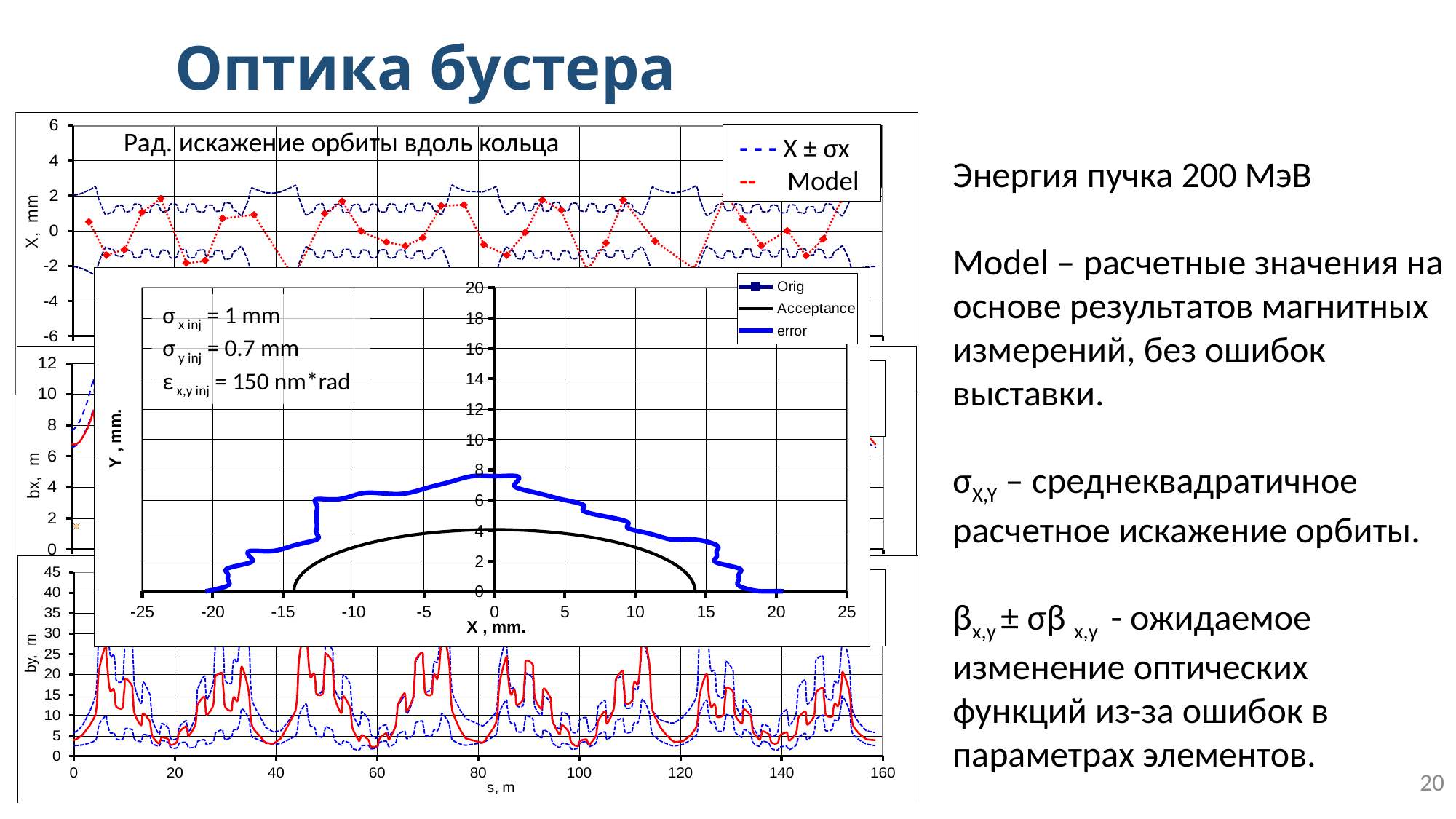
In the top chart titled 'Рад. искажение орбиты вдоль кольца', what are the two legend entries? X ± σx and Model What kind of chart is the top chart titled 'Рад. искажение орбиты вдоль кольца'? line chart In the top chart titled 'Рад. искажение орбиты вдоль кольца', is the value of the Model series at s ≈ 0 greater or less than 2? less In the overlaid chart with axes 'X , mm.' and 'Y , mm.', is the value of the 'Acceptance' curve at X = 0 greater or less than 6? less In the overlaid chart with axes 'X , mm.' and 'Y , mm.', is the value of the 'error' curve at X = 0 greater or less than 6? greater In the overlaid chart with axes 'X , mm.' and 'Y , mm.', what are the legend entries? Orig, Acceptance, error In the overlaid chart with axes 'X , mm.' and 'Y , mm.', which curve is higher at X = 0, 'error' or 'Acceptance'? error In the overlaid chart with axes 'X , mm.' and 'Y , mm.', what is the maximum value shown on the Y axis? 20 In the overlaid chart with axes 'X , mm.' and 'Y , mm.', how many series does the legend list? 3 In the bottom chart with y axis 'by, m', what is the maximum value shown on the x axis 's, m'? 160 In the top chart titled 'Рад. искажение орбиты вдоль кольца', how many series does the legend list? 2